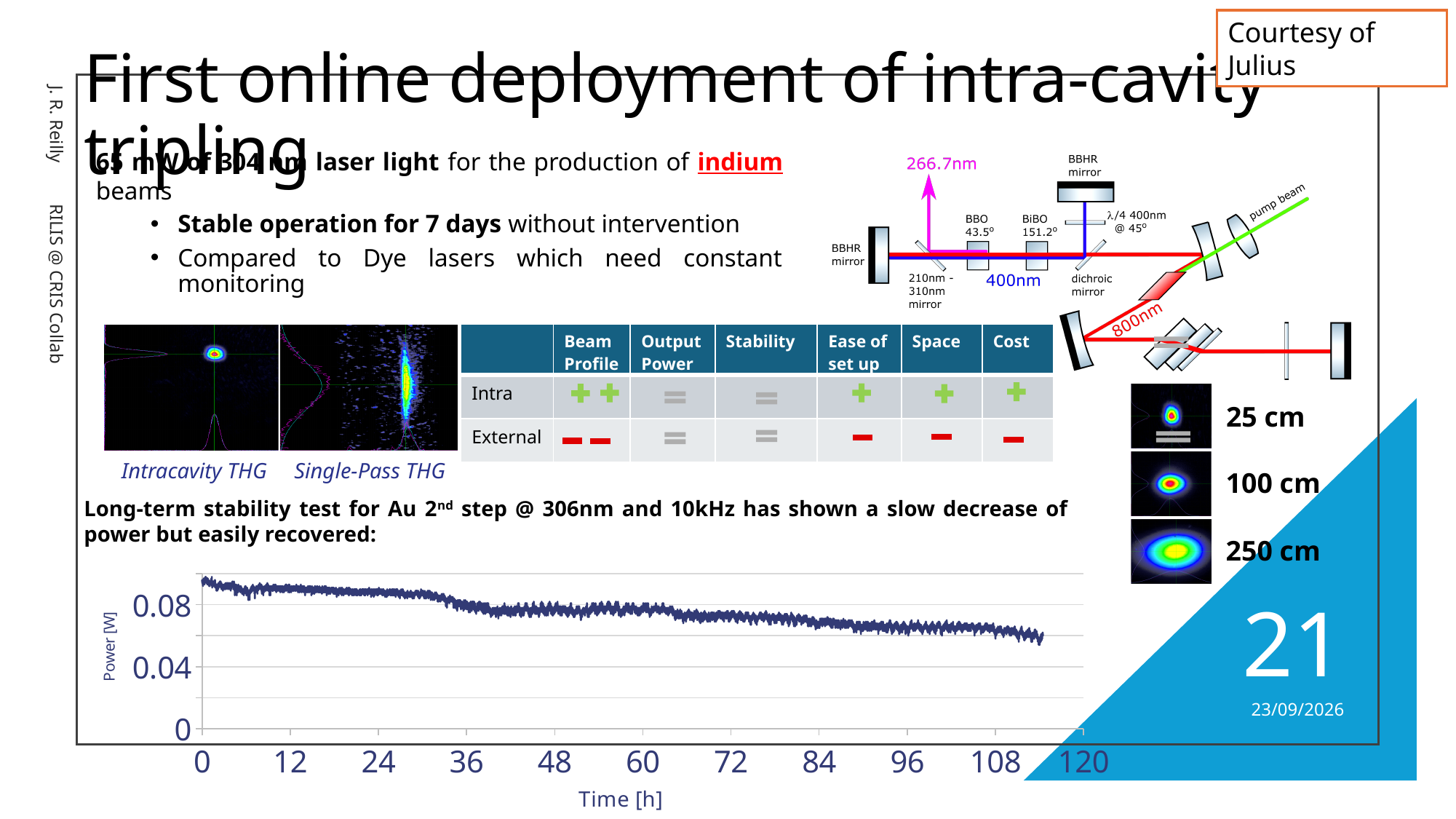
In the long-term stability chart, is the power at 108 h greater or less than 0.08 W? less In the long-term stability chart, is the power higher at 12 h or at 96 h? 12 h What kind of chart is the long-term stability plot at the bottom of the slide? line chart What is the label of the y axis of the long-term stability chart? Power [W] How many lines are plotted in the long-term stability chart? 1 What is the label of the x axis of the long-term stability chart? Time [h] In the long-term stability chart, is the power at 0 h greater or less than 0.08 W? greater In the long-term stability chart, does the power rise or fall as time increases along the x axis? fall In the long-term stability chart, is the power at 60 h greater or less than 0.04 W? greater